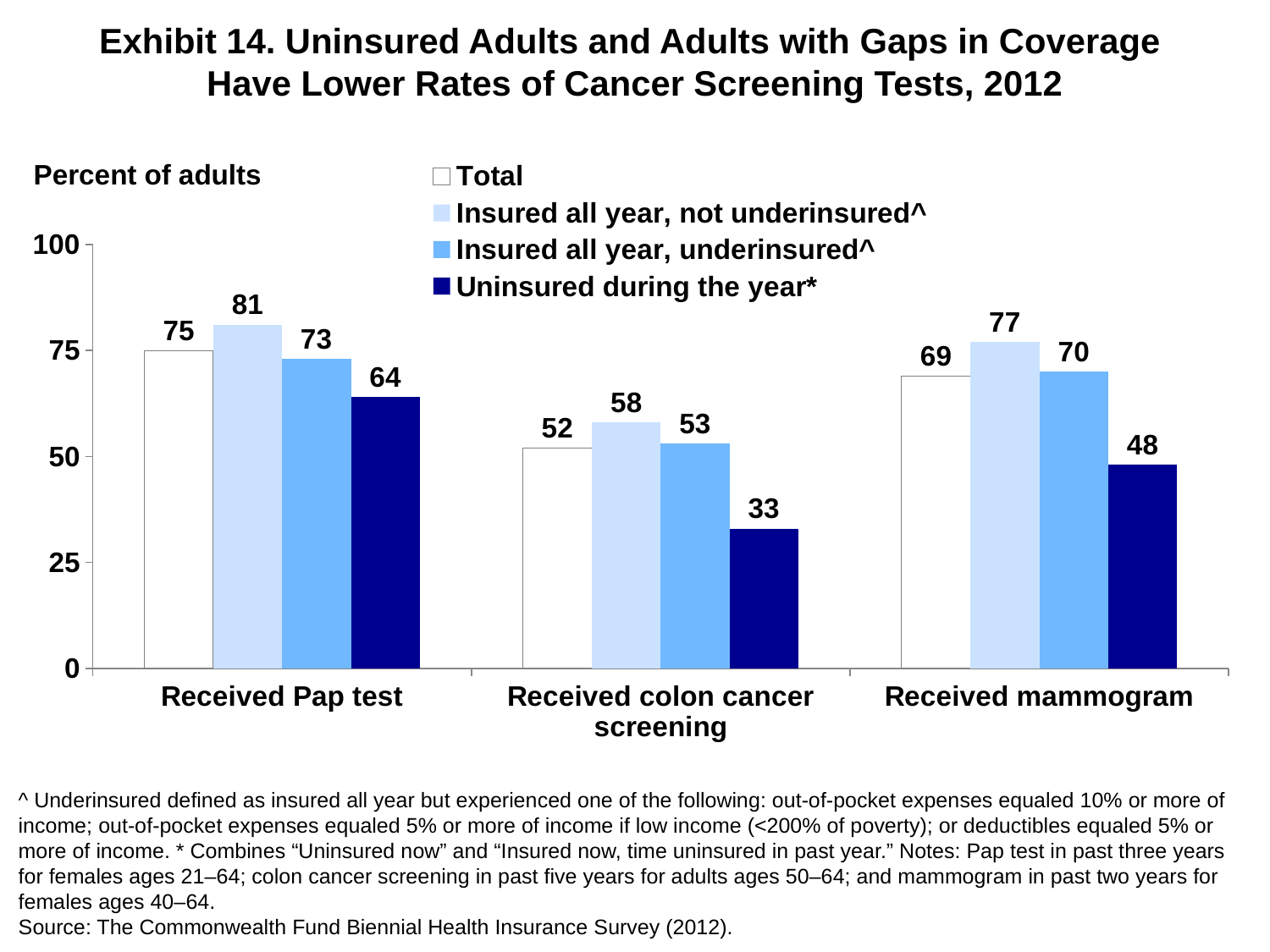
Which category has the highest value for 'Uninsured during the year*'? Received Pap test What is the difference between the 'Insured all year, not underinsured^' and 'Uninsured during the year*' values for 'Received mammogram'? 29 Which is larger for 'Received Pap test': the 'Insured all year, underinsured^' value or the 'Uninsured during the year*' value? Insured all year, underinsured^ What is the value for 'Uninsured during the year*' for 'Received colon cancer screening'? 33 Is the 'Uninsured during the year*' value for 'Received colon cancer screening' greater or less than 50? less What is the label on the y axis of the chart? Percent of adults How many categories are shown on the x axis? 3 How many series does the legend list? 4 What is the value for 'Insured all year, not underinsured^' for 'Received Pap test'? 81 What is the 'Total' value for 'Received mammogram'? 69 What kind of chart is shown on the slide? bar chart Which category has the lowest 'Total' value? Received colon cancer screening